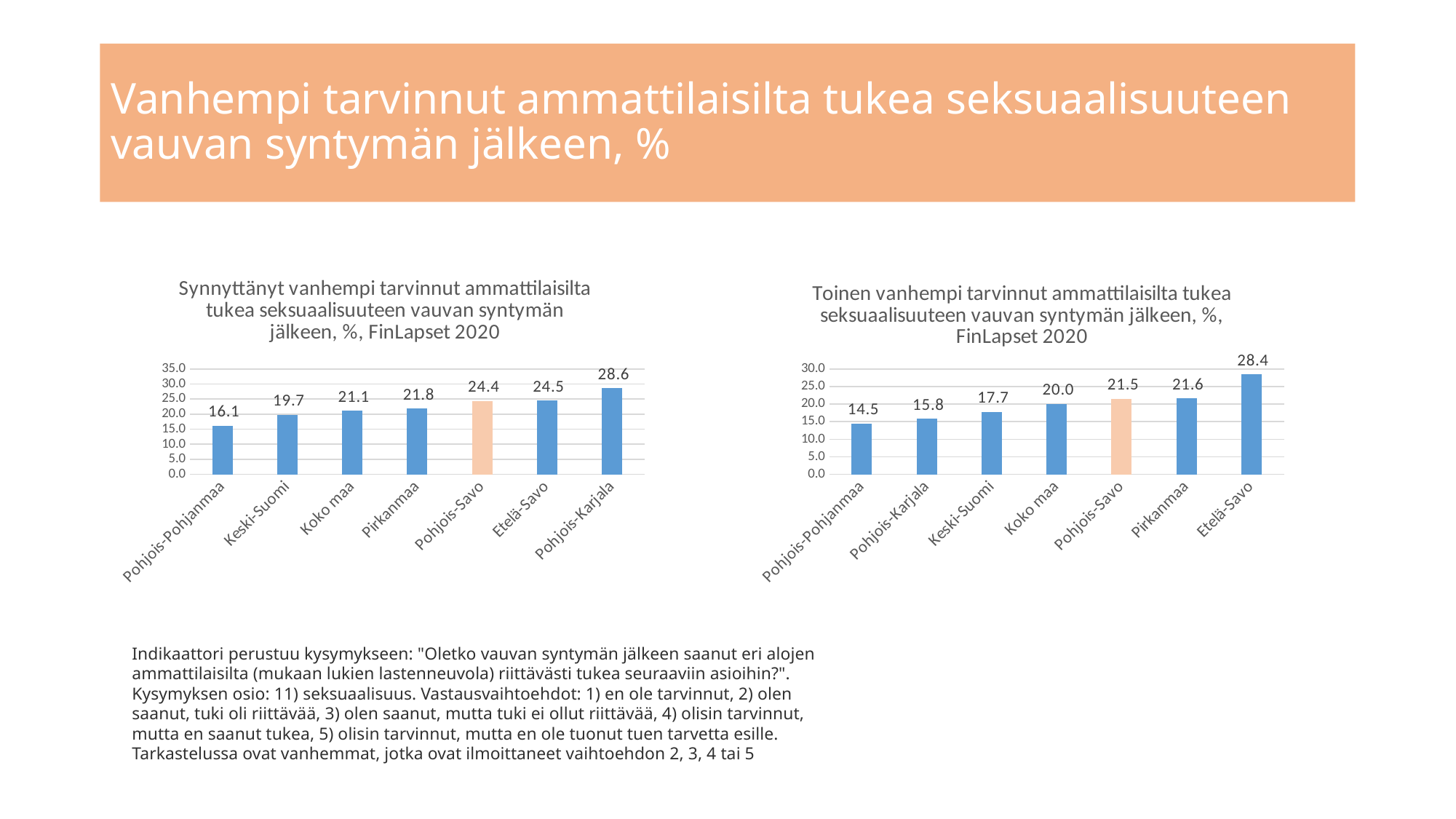
In the right chart (Toinen vanhempi), which is larger: Keski-Suomi or Pirkanmaa? Pirkanmaa In the left chart (Synnyttänyt vanhempi), what is the value for Pohjois-Savo? 24.4 In the left chart (Synnyttänyt vanhempi), which bar is coloured differently (light orange) from the others? Pohjois-Savo In the right chart (Toinen vanhempi), what is the value for Koko maa? 20.0 In the left chart (Synnyttänyt vanhempi), which category has the highest value? Pohjois-Karjala How many categories are shown in the right chart (Toinen vanhempi)? 7 In the left chart (Synnyttänyt vanhempi), what is the difference between Pohjois-Karjala and Pohjois-Pohjanmaa? 12.5 What kind of chart is the left chart (Synnyttänyt vanhempi)? bar chart In the right chart (Toinen vanhempi), do the values rise or fall from left to right? rise In the left chart (Synnyttänyt vanhempi), is the value for Keski-Suomi greater or less than 25.0? less In the right chart (Toinen vanhempi), which category has the lowest value? Pohjois-Pohjanmaa In the right chart (Toinen vanhempi), what is the difference between Etelä-Savo and Pohjois-Karjala? 12.6